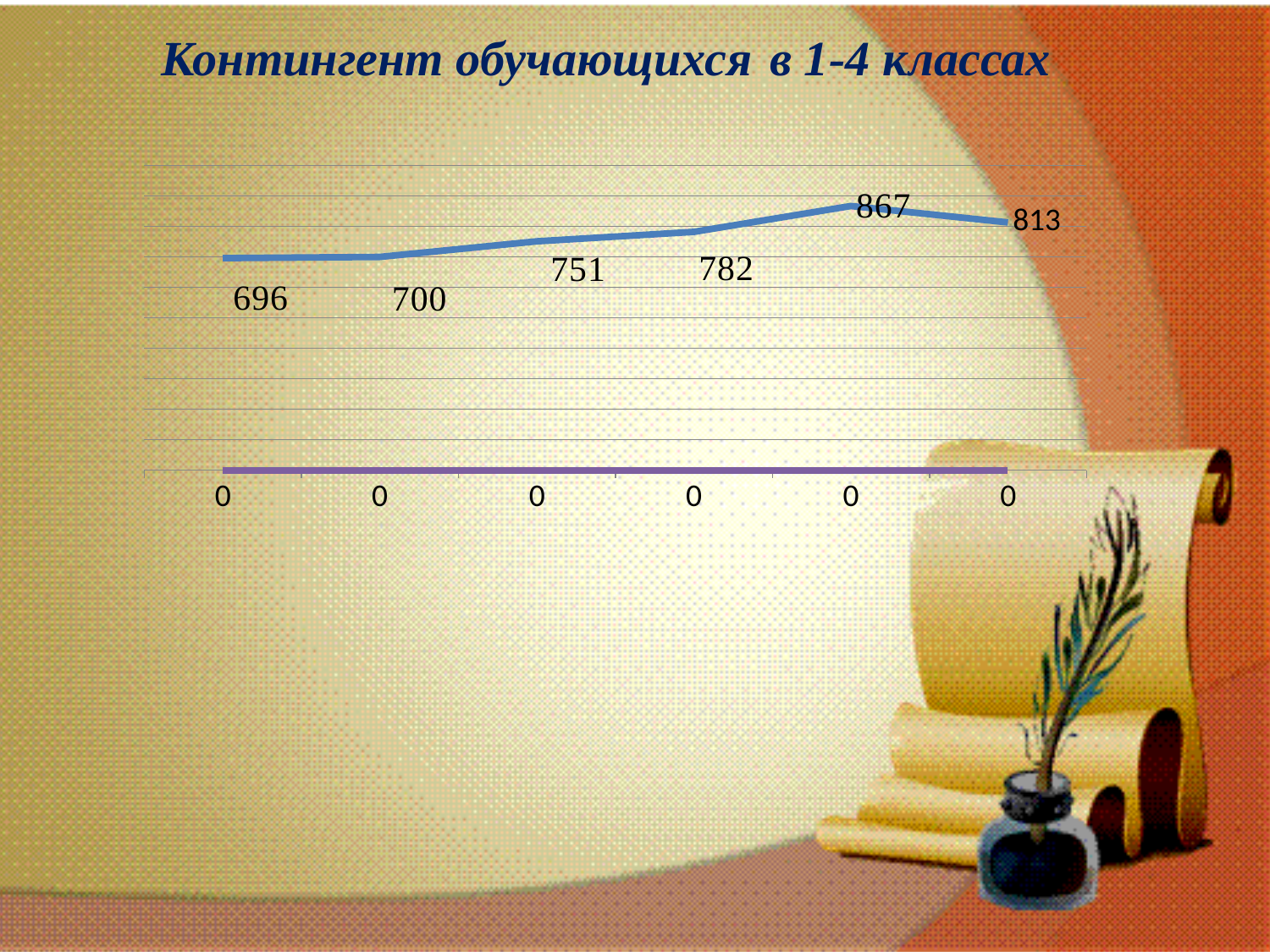
What is the value of the fourth data point on the line chart? 782 What is the difference between the highest value (867) and the lowest value (696) on the chart? 171 By how much does the value drop from the fifth point (867) to the sixth point (813)? 54 What is the title of the chart on the slide? Контингент обучающихся в 1-4 классах Which is larger, the second data point or the third data point? the third data point (751) What type of chart is shown on the slide? line chart What is the value of the last (sixth) data point on the line chart? 813 How many labelled data points are on the line chart? 6 What is the lowest value shown on the line chart? 696 What is the value of the third data point on the line chart? 751 What is the highest value shown on the line chart? 867 What is the value of the first data point on the line chart? 696